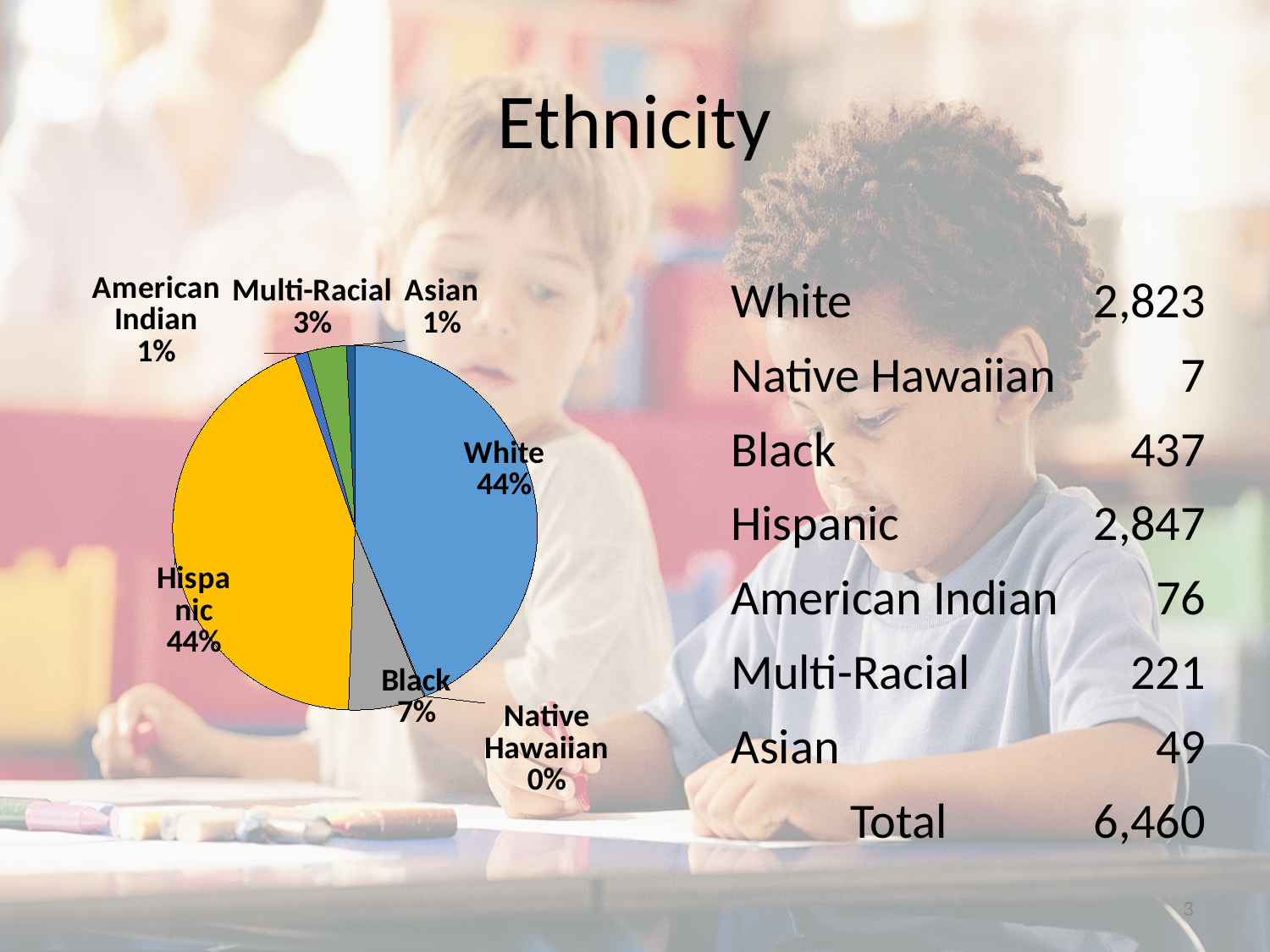
What percentage is shown for the Multi-Racial slice? 3% What percentage is shown for the Hispanic slice? 44% How many slices (categories) does the pie chart have? 7 What percentage is shown for the Asian slice? 1% What colour is the Hispanic slice of the pie chart? yellow What is the difference in percentage points between the Black slice and the Multi-Racial slice? 4% What kind of chart is shown on the slide? pie chart What is the title of the slide containing the pie chart? Ethnicity Which slice of the pie has the smallest share? Native Hawaiian Which slice is larger, Black or Multi-Racial? Black What share of the pie does the Black slice represent? 7% What percentage is shown for the Native Hawaiian slice? 0%